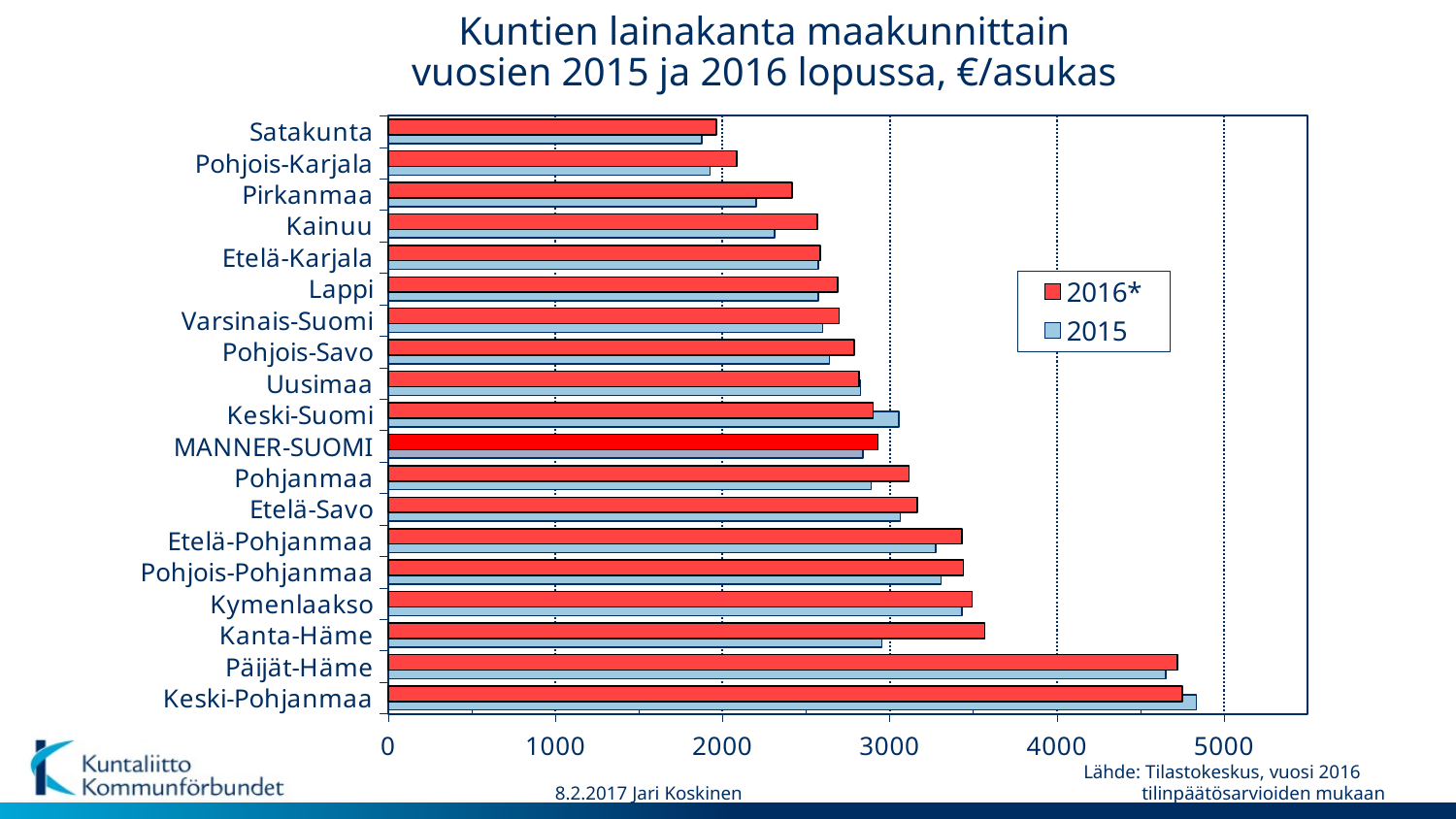
Which region has the highest value for 2015? Keski-Pohjanmaa Is the 2015 value for Pohjanmaa greater or less than 3000? less How many regions (categories) are shown on the chart? 19 What are the two legend entries on the chart? 2016* and 2015 Is the 2016* value for Kanta-Häme greater or less than 3000? greater For Kanta-Häme, which is larger: the 2016* value or the 2015 value? 2016* What kind of chart is shown on the slide? Bar chart Which region has the highest value for 2016*? Keski-Pohjanmaa Is the 2016* value for Päijät-Häme greater or less than 4000? greater Which region has the lowest value for 2016*? Satakunta How many series does the legend list? 2